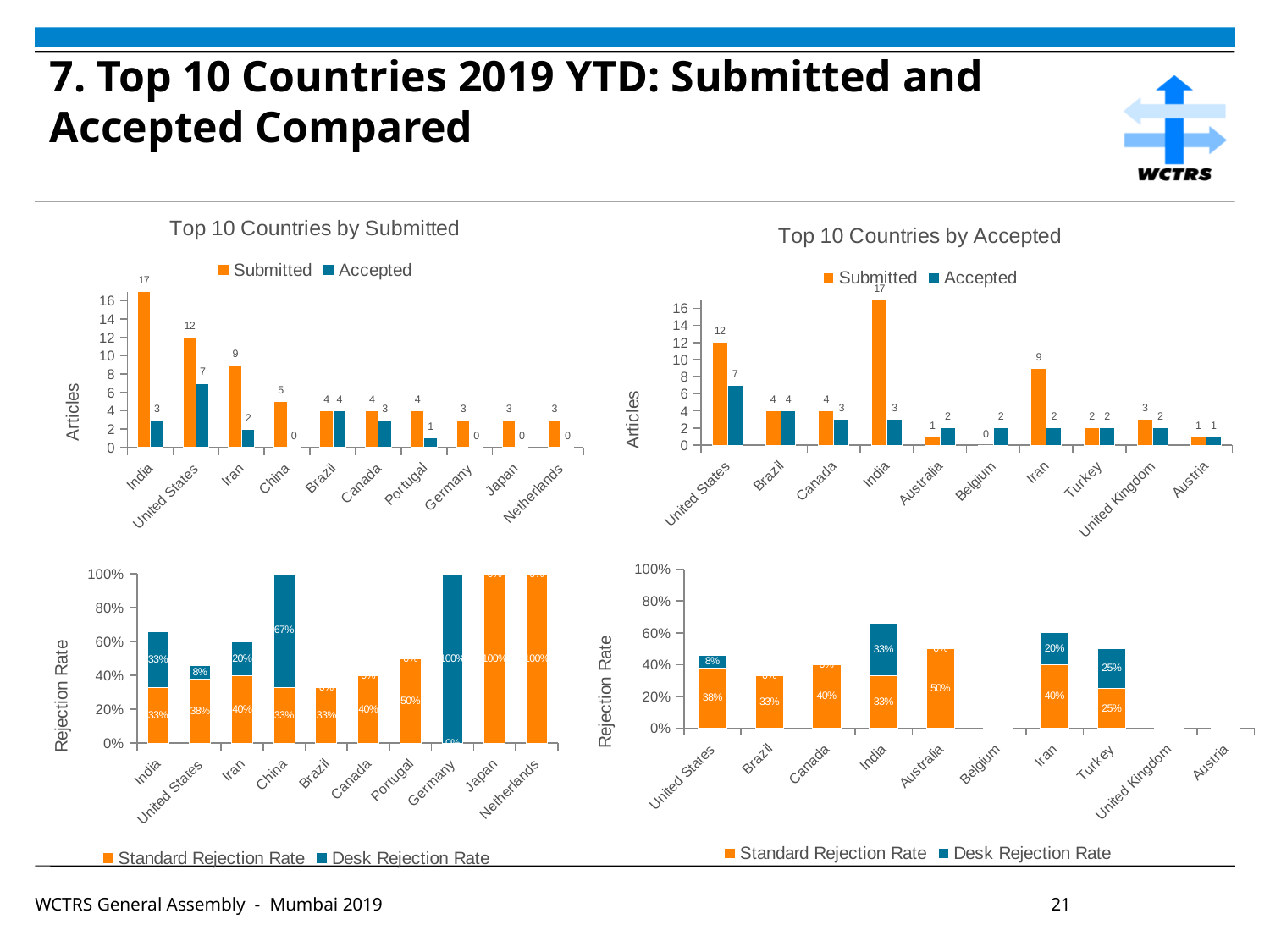
In the 'Top 10 Countries by Accepted' chart, how many articles were accepted from Belgium? 2 In the 'Top 10 Countries by Submitted' chart, what is the difference between submitted and accepted articles for Iran? 7 In the 'Top 10 Countries by Submitted' chart, which country has the highest number of submitted articles? India In the 'Top 10 Countries by Submitted' chart, how many countries are shown on the x axis? 10 In the 'Top 10 Countries by Submitted' chart, how many articles were accepted from the United States? 7 In the 'Top 10 Countries by Submitted' chart, how many articles were submitted from India? 17 In the 'Top 10 Countries by Accepted' chart, which is larger for Australia: submitted or accepted articles? Accepted In the bottom-left rejection rate chart, what is the total rejection rate (standard plus desk) for the United States? 46% What kind of chart is the bottom-right rejection rate chart? Stacked bar chart In the 'Top 10 Countries by Accepted' chart, how many series does the legend list? 2 In the 'Top 10 Countries by Accepted' chart, which country has the highest number of accepted articles? United States In the bottom-left rejection rate chart, what is the desk rejection rate for China? 67%